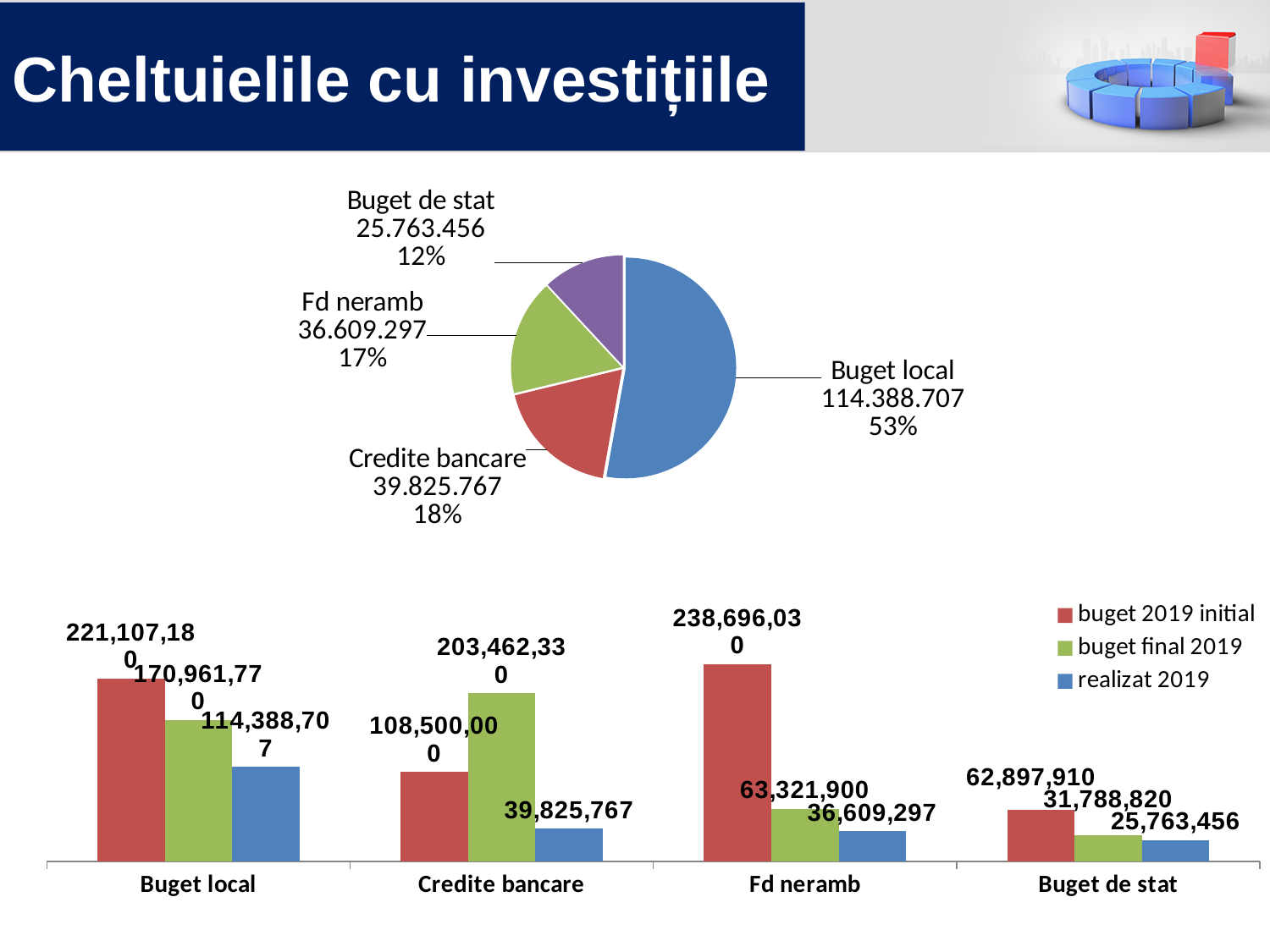
In the pie chart, which category has the smallest slice? Buget de stat In the bar chart at the bottom, how many series does the legend list? 3 In the bar chart at the bottom, what is the value of buget 2019 initial for Fd neramb? 238,696,030 In the bar chart at the bottom, which is larger for Credite bancare: buget 2019 initial or buget final 2019? buget final 2019 In the pie chart, what share does Buget local have? 53% In the bar chart at the bottom, what is the value of buget final 2019 for Credite bancare? 203,462,330 In the pie chart, how many slices are there? 4 In the bar chart at the bottom, what is the difference between buget 2019 initial and realizat 2019 for Buget de stat? 37,134,454 What type of chart is shown at the bottom of the slide? bar chart In the bar chart at the bottom, which category has the highest realizat 2019 value? Buget local In the pie chart, what is the value shown for Credite bancare? 39.825.767 In the pie chart, what percentage is shown for Fd neramb? 17%